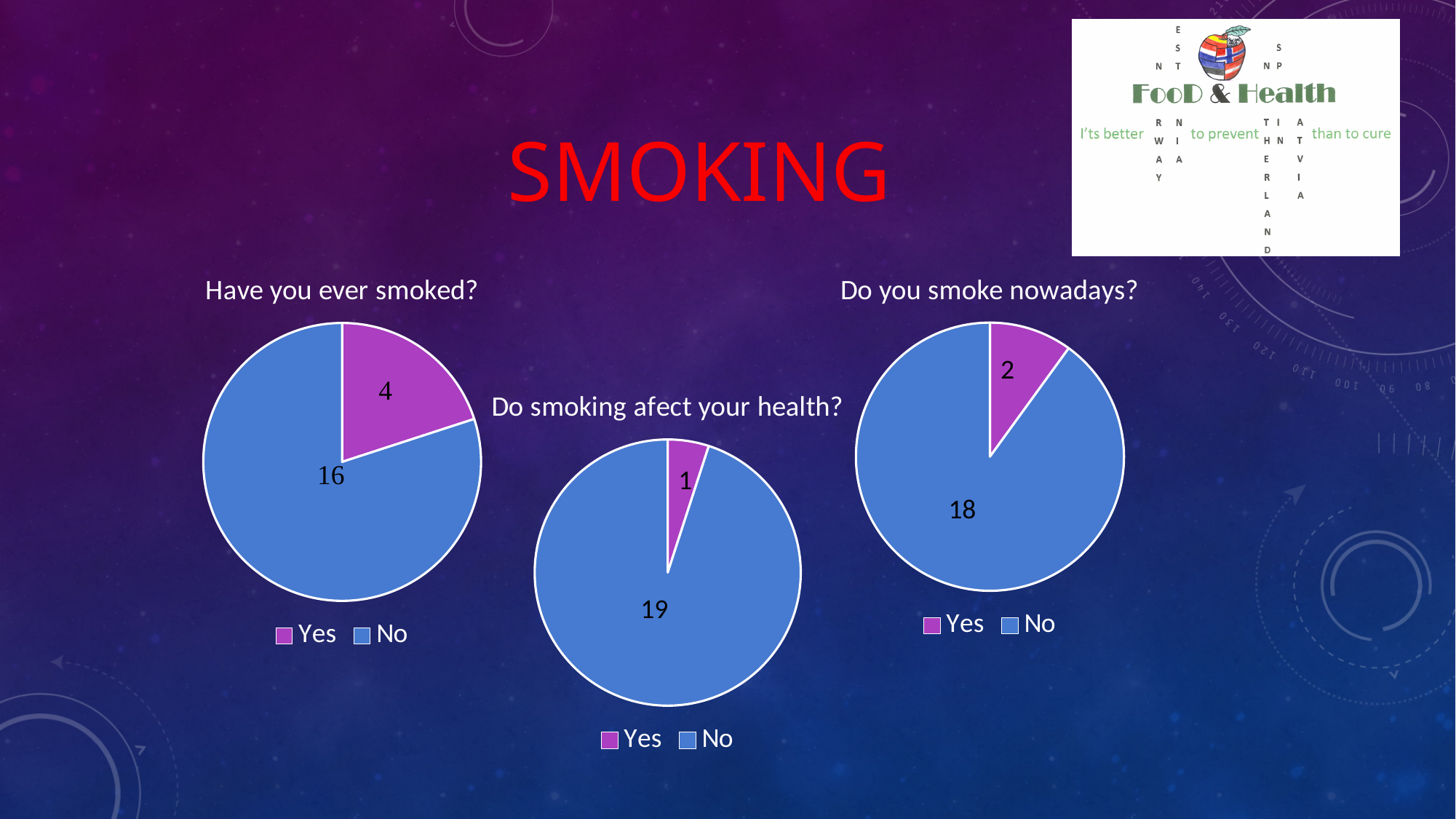
In the 'Have you ever smoked?' chart, what is the value for No? 16 How many categories does the legend of the 'Have you ever smoked?' chart list? 2 What kind of chart is used for 'Do you smoke nowadays?'? Pie chart In the 'Do smoking afect your health?' chart, what is the value for No? 19 In the 'Have you ever smoked?' chart, which category has the largest slice? No In the 'Do smoking afect your health?' chart, what share of the pie does the Yes slice represent? 5% In the 'Do smoking afect your health?' chart, what is the value for Yes? 1 In the 'Do you smoke nowadays?' chart, what is the value for Yes? 2 In the 'Do you smoke nowadays?' chart, which category has the smallest slice? Yes In the 'Have you ever smoked?' chart, what is the value for Yes? 4 In the 'Do you smoke nowadays?' chart, what is the value for No? 18 In the 'Have you ever smoked?' chart, what is the difference between the No and Yes values? 12